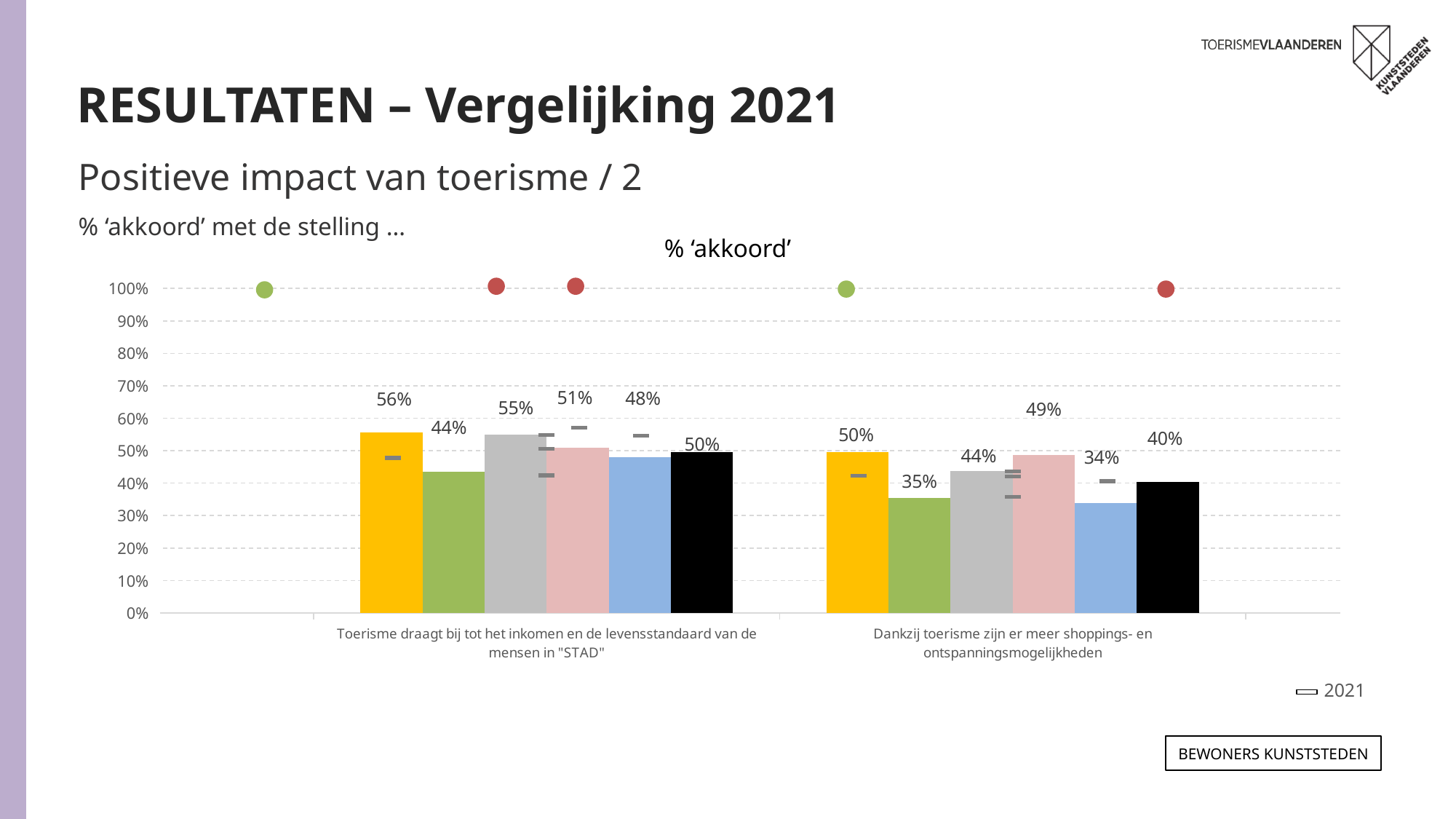
What is the difference between the pink bar values of the two statements (51% vs 49%)? 2 percentage points Which coloured bar is the lowest for the statement "Dankzij toerisme zijn er meer shoppings- en ontspanningsmogelijkheden"? blue (34%) How many statement categories are shown on the x axis? 2 Which coloured bar is the highest for the statement "Toerisme draagt bij tot het inkomen en de levensstandaard van de mensen in 'STAD'"? yellow (56%) What kind of chart is shown on the slide? bar chart What year does the legend marker at the bottom right refer to? 2021 What is the value of the black bar for the statement "Dankzij toerisme zijn er meer shoppings- en ontspanningsmogelijkheden"? 40% What is the chart's title? % ‘akkoord’ What is the difference between the yellow bar and the green bar for the statement "Toerisme draagt bij tot het inkomen en de levensstandaard van de mensen in 'STAD'"? 12 percentage points Which is larger for the statement "Dankzij toerisme zijn er meer shoppings- en ontspanningsmogelijkheden": the pink bar or the grey bar? the pink bar (49%) What is the value of the yellow bar for the statement "Toerisme draagt bij tot het inkomen en de levensstandaard van de mensen in 'STAD'"? 56% What is the value of the green bar for the statement "Dankzij toerisme zijn er meer shoppings- en ontspanningsmogelijkheden"? 35%